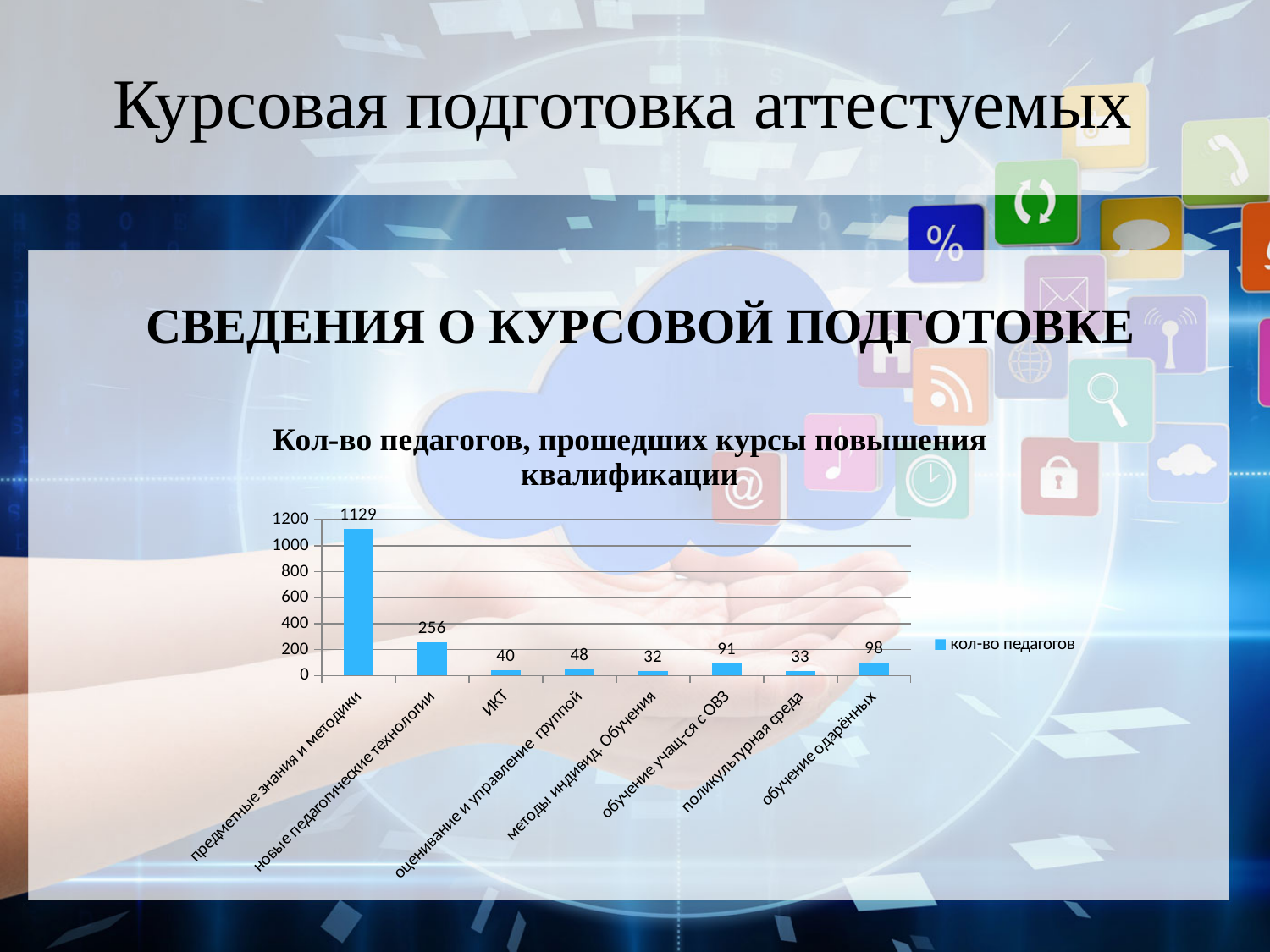
Is the value for "новые педагогические технологии" greater or less than 200? greater Which category has the highest value? предметные знания и методики How many categories are shown on the x axis? 8 What is the value for "обучение одарённых"? 98 What is the value for "ИКТ"? 40 What is the difference between the values for "предметные знания и методики" and "новые педагогические технологии"? 873 What is the value for "новые педагогические технологии"? 256 What kind of chart is shown on the slide? bar chart What is the value for "предметные знания и методики"? 1129 How many series does the legend list? 1 Which category has the lowest value? методы индивид. обучения Which is larger: the value for "обучение учащ-ся с ОВЗ" or for "обучение одарённых"? обучение одарённых